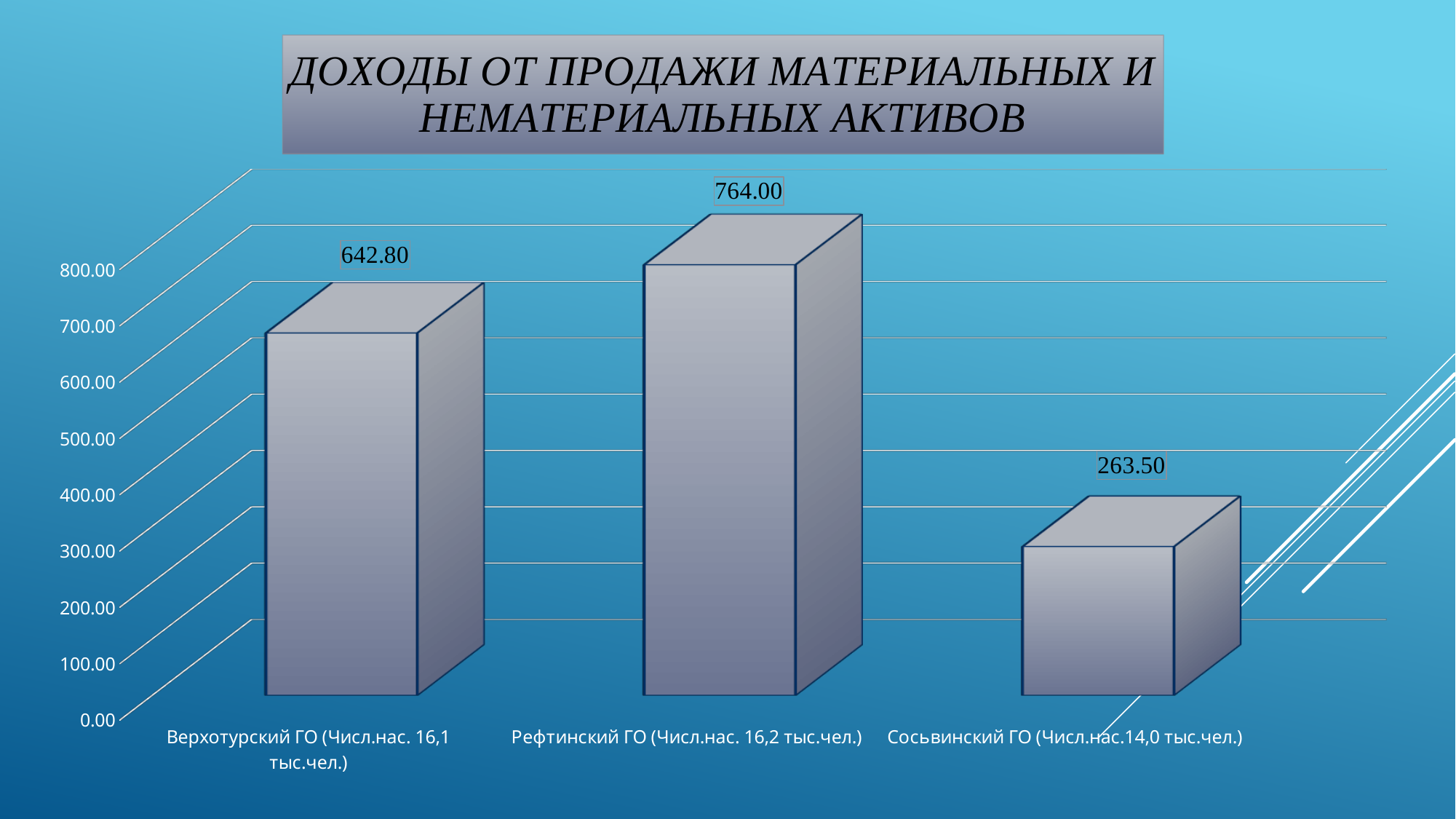
How many categories are shown on the chart? 3 What is the difference between the values for Рефтинский ГО and Верхотурский ГО? 121.20 What is the difference between the values for Верхотурский ГО and Сосьвинский ГО? 379.30 What is the title of the chart? ДОХОДЫ ОТ ПРОДАЖИ МАТЕРИАЛЬНЫХ И НЕМАТЕРИАЛЬНЫХ АКТИВОВ Which is larger, the value for Верхотурский ГО or the value for Сосьвинский ГО? Верхотурский ГО What kind of chart is shown on the slide? bar chart Which category has the highest value? Рефтинский ГО Which category has the lowest value? Сосьвинский ГО What is the value for Сосьвинский ГО? 263.50 Is the value for Сосьвинский ГО greater or less than 300.00? less What is the value for Рефтинский ГО? 764.00 What is the value for Верхотурский ГО? 642.80